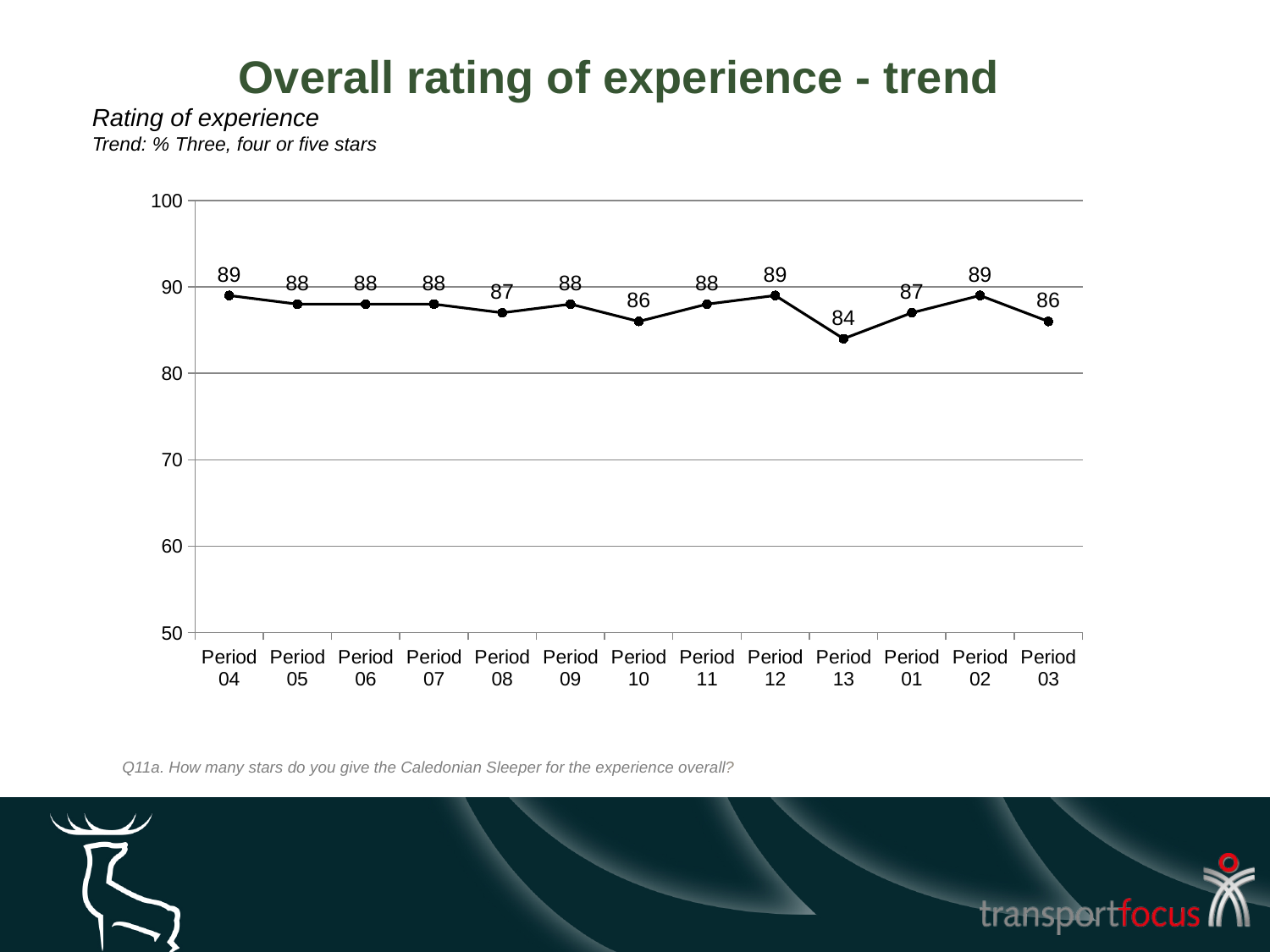
Which is larger, the value for Period 08 or the value for Period 13? Period 08 What is the value for Period 01? 87 What kind of chart is shown on the slide? line chart What is the value for Period 13? 84 What is the difference between the values for Period 02 and Period 03? 3 What is the value for Period 04? 89 What is the value for Period 10? 86 Is the value for Period 13 greater or less than 90? less How many periods are plotted on the chart? 13 What is the difference between the values for Period 12 and Period 13? 5 Which period has the lowest value? Period 13 What is the title of the slide? Overall rating of experience - trend